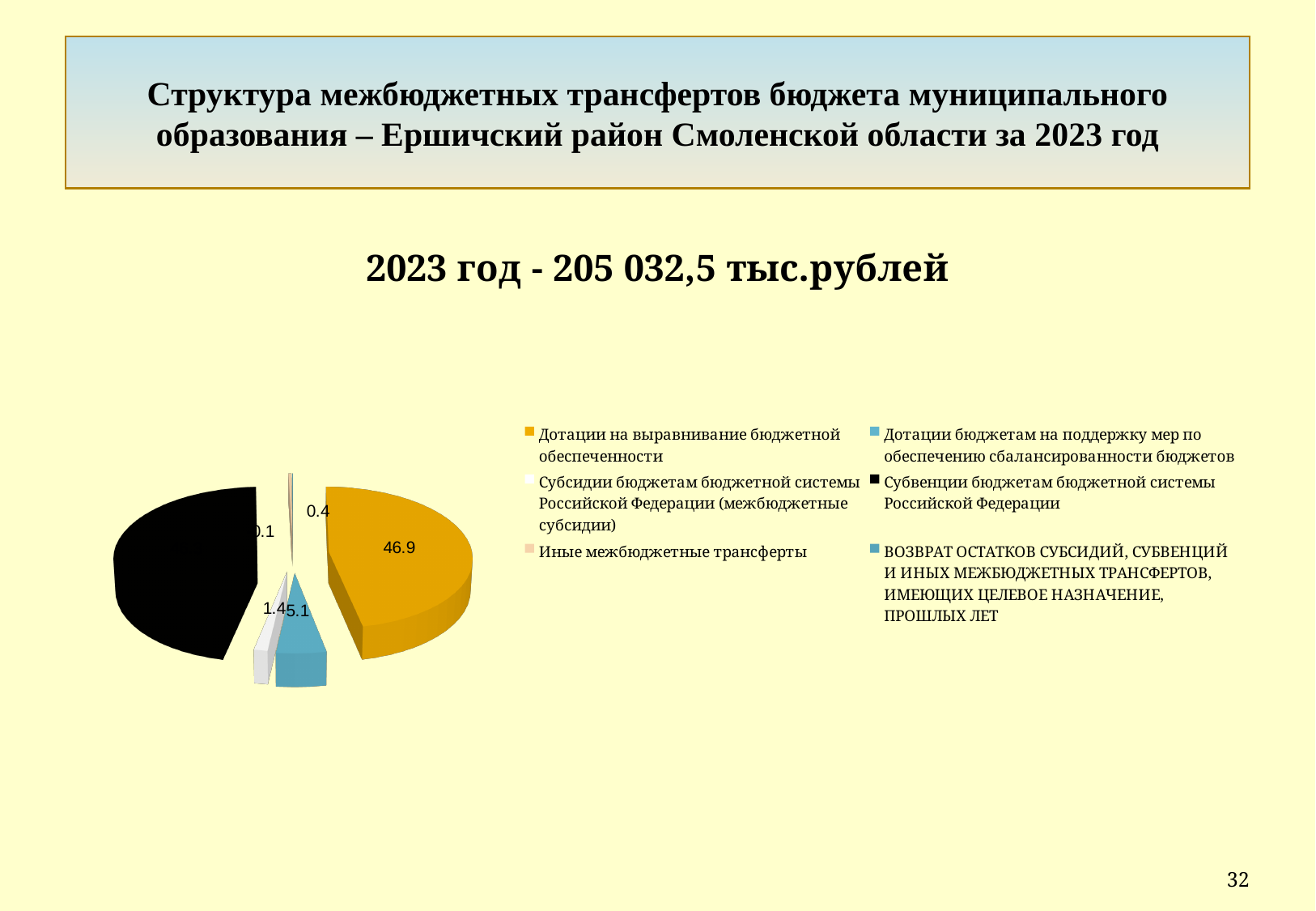
Which is larger: the slice for "Дотации на выравнивание бюджетной обеспеченности" or the slice for "Иные межбюджетные трансферты"? Дотации на выравнивание бюджетной обеспеченности What total amount for 2023 is stated above the pie chart? 205 032,5 тыс.рублей What value is shown for the slice "Дотации на выравнивание бюджетной обеспеченности"? 46.9 What colour is the slice for "Субвенции бюджетам бюджетной системы Российской Федерации"? black Which is larger: the slice for "Дотации бюджетам на поддержку мер по обеспечению сбалансированности бюджетов" or the slice for "Субсидии бюджетам бюджетной системы Российской Федерации (межбюджетные субсидии)"? Дотации бюджетам на поддержку мер по обеспечению сбалансированности бюджетов What is the difference between the values for "Дотации бюджетам на поддержку мер по обеспечению сбалансированности бюджетов" (5.1) and "Субсидии бюджетам бюджетной системы Российской Федерации (межбюджетные субсидии)" (1.4)? 3.7 How many entries does the legend of the pie chart list? 6 What value is shown for the slice "Дотации бюджетам на поддержку мер по обеспечению сбалансированности бюджетов"? 5.1 What is the difference between the values for "Дотации на выравнивание бюджетной обеспеченности" (46.9) and "Дотации бюджетам на поддержку мер по обеспечению сбалансированности бюджетов" (5.1)? 41.8 What value is shown for the slice "Субсидии бюджетам бюджетной системы Российской Федерации (межбюджетные субсидии)"? 1.4 What kind of chart is shown on the slide? pie chart What value is shown for the slice "Иные межбюджетные трансферты"? 0.4